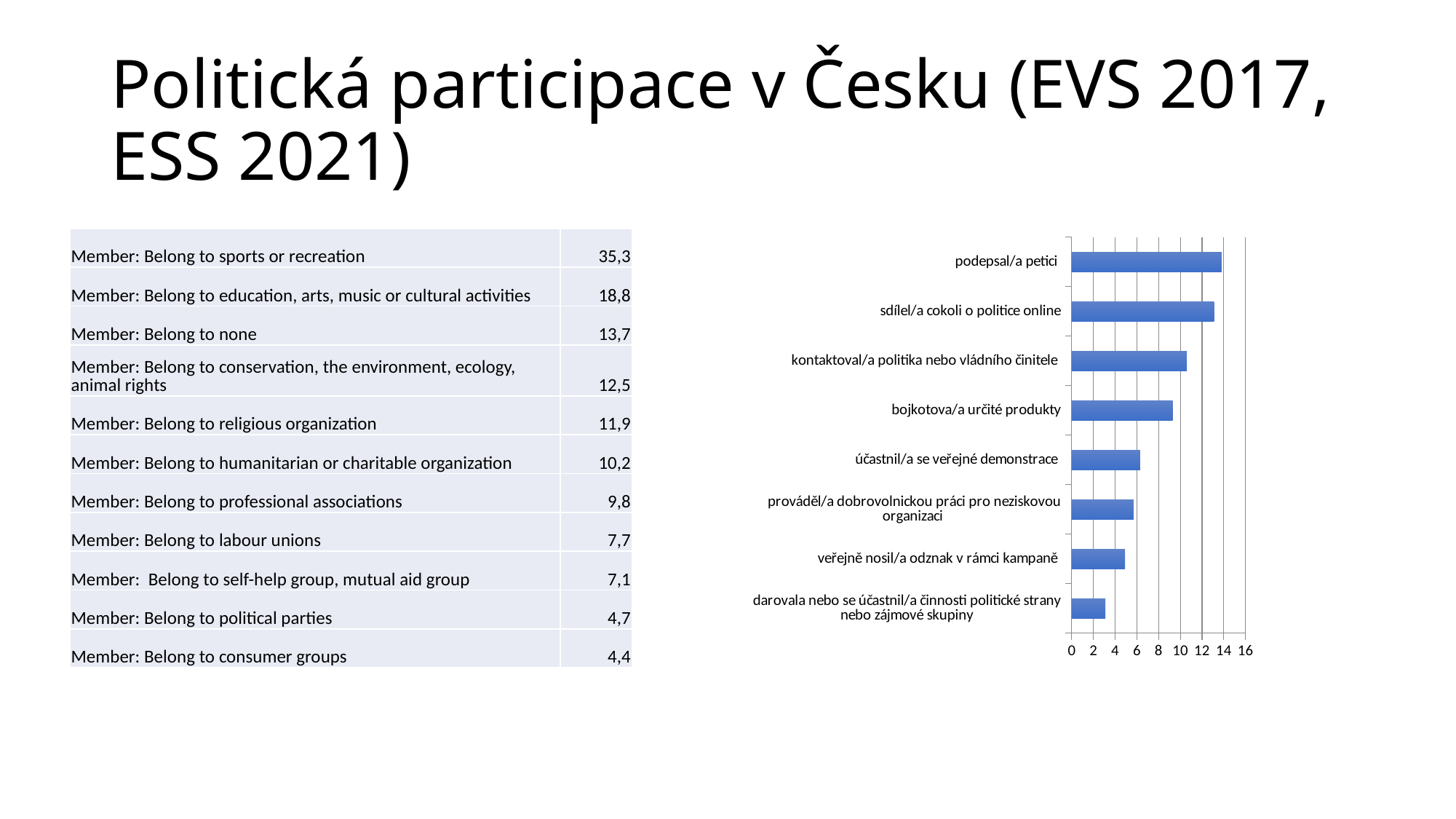
In the bar chart on the right, is the value for 'sdílel/a cokoli o politice online' greater or less than 10? greater In the bar chart on the right, which category has the lowest value? darovala nebo se účastnil/a činnosti politické strany nebo zájmové skupiny In the bar chart on the right, is the value for 'darovala nebo se účastnil/a činnosti politické strany nebo zájmové skupiny' greater or less than 4? less In the bar chart on the right, which is larger: 'účastnil/a se veřejné demonstrace' or 'veřejně nosil/a odznak v rámci kampaně'? účastnil/a se veřejné demonstrace In the bar chart on the right, which is larger: 'kontaktoval/a politika nebo vládního činitele' or 'bojkotova/a určité produkty'? kontaktoval/a politika nebo vládního činitele In the bar chart on the right, is the value for 'bojkotova/a určité produkty' greater or less than 10? less How many categories (bars) does the bar chart on the right show? 8 What is the highest tick value shown on the horizontal axis of the bar chart on the right? 16 What kind of chart is shown on the right side of the slide? bar chart